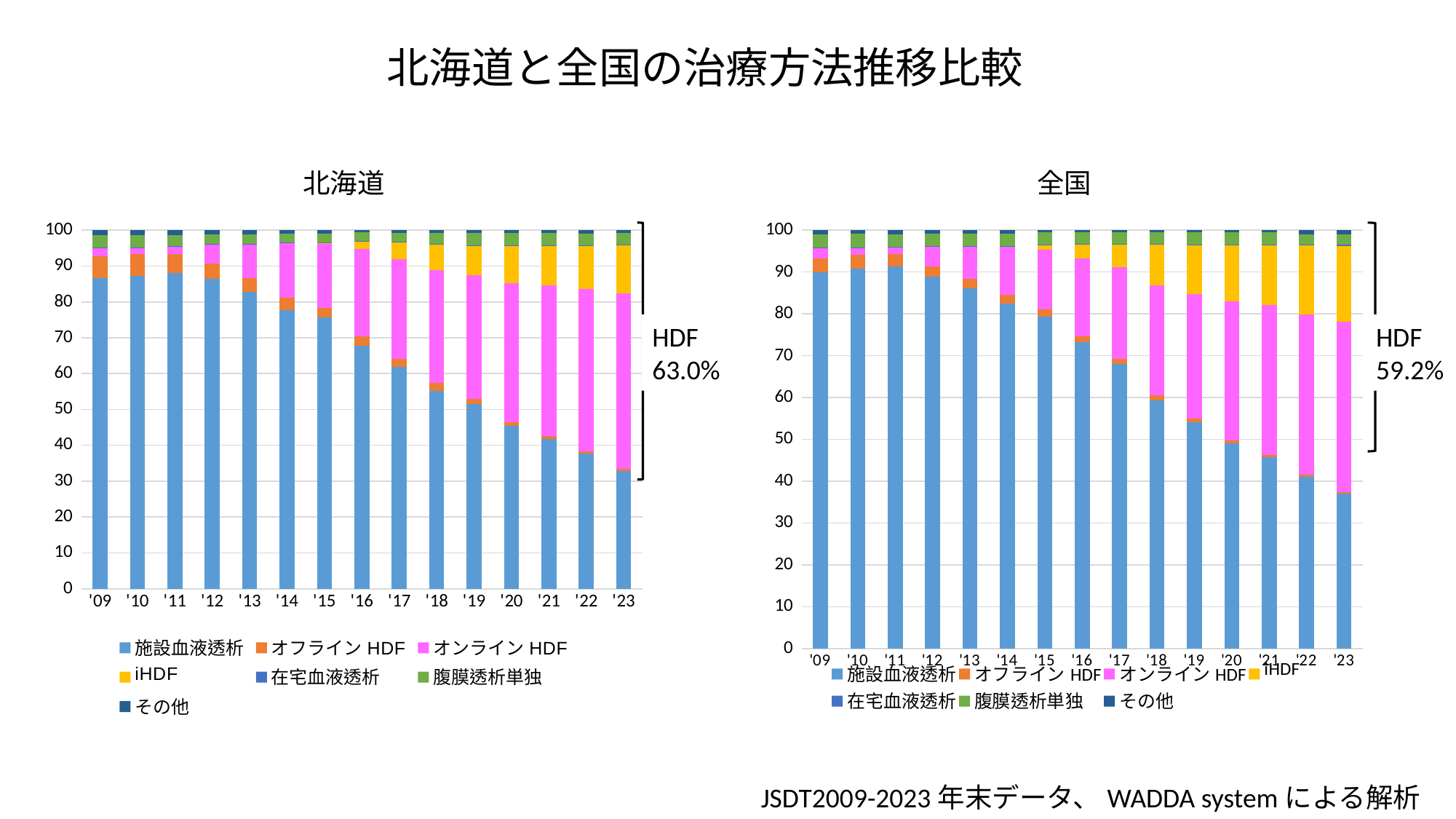
In the 北海道 chart, is the 施設血液透析 value for '09 greater or less than 80? greater What kind of chart is the 北海道 chart? stacked bar chart What HDF percentage is annotated next to the 北海道 chart? 63.0% In the 全国 chart, is the 施設血液透析 value for '09 greater or less than 80? greater How many years are shown on the x axis of the 全国 chart? 15 In the 北海道 chart, does the 施設血液透析 share rise or fall from '09 to '23? fall In the 全国 chart, does the オンライン HDF share rise or fall from '13 to '23? rise In the 北海道 chart, which year has the lowest 施設血液透析 value? '23 How many series does the legend of the 北海道 chart list? 7 In the 全国 chart, is the 施設血液透析 value for '23 greater or less than 40? less What HDF percentage is annotated next to the 全国 chart? 59.2%